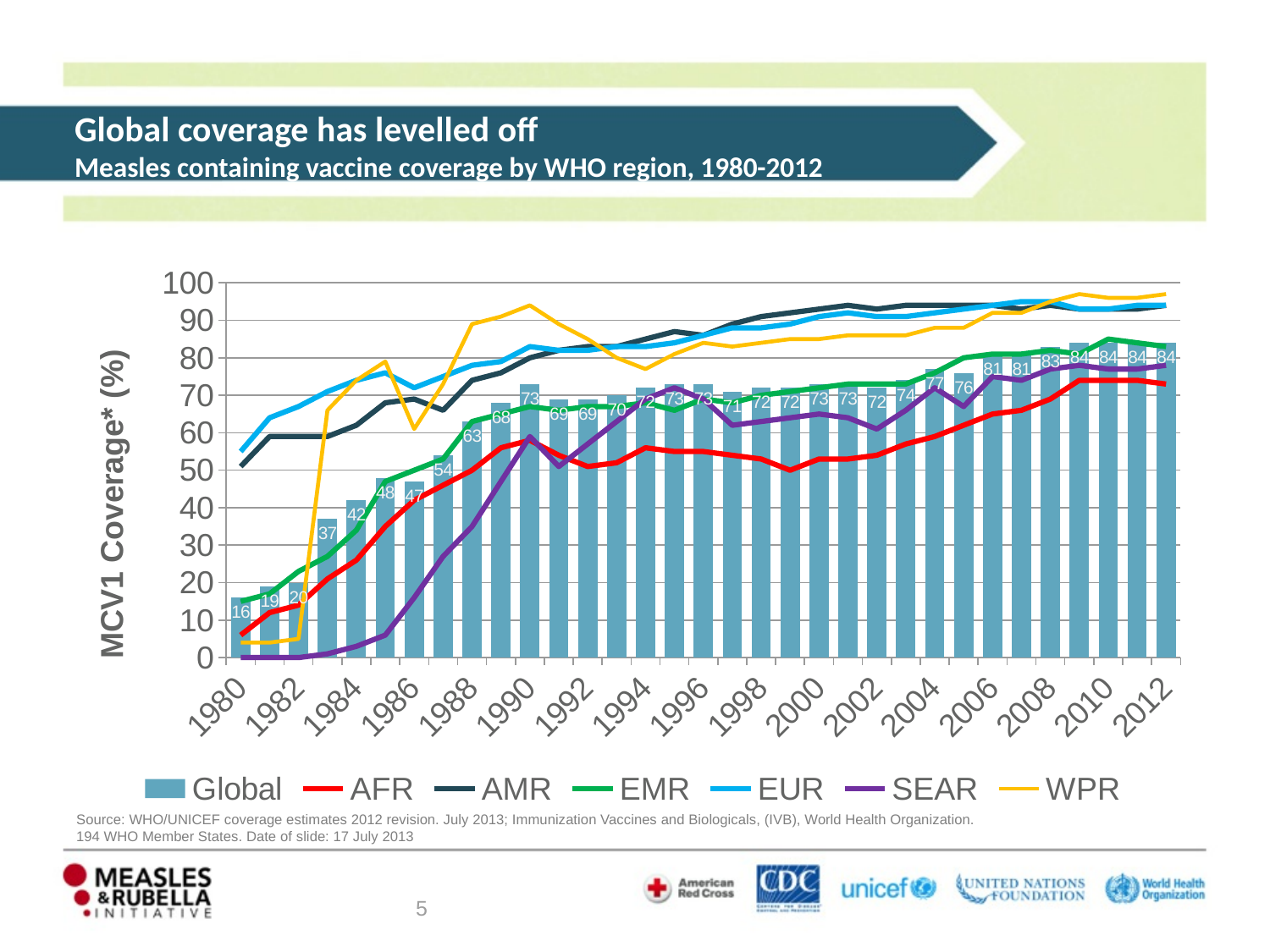
What is the title of the vertical axis? MCV1 Coverage* (%) How many series does the legend list? 7 Do the Global coverage bars generally rise or fall from 1980 to 2012? Rise What is the Global coverage value for 2012? 84 What is the Global coverage value for 1990? 73 What is the highest Global coverage value shown on the bars? 84 Is the AFR value for 2012 greater or less than 80? less In which year is the Global coverage bar lowest? 1980 What kind of chart is shown on the slide? Combined bar and line chart What is the difference between the Global coverage values for 2012 and 1980? 68 Which is larger, the Global coverage value for 1983 or for 1984? 1984 What is the Global coverage value for 1980? 16